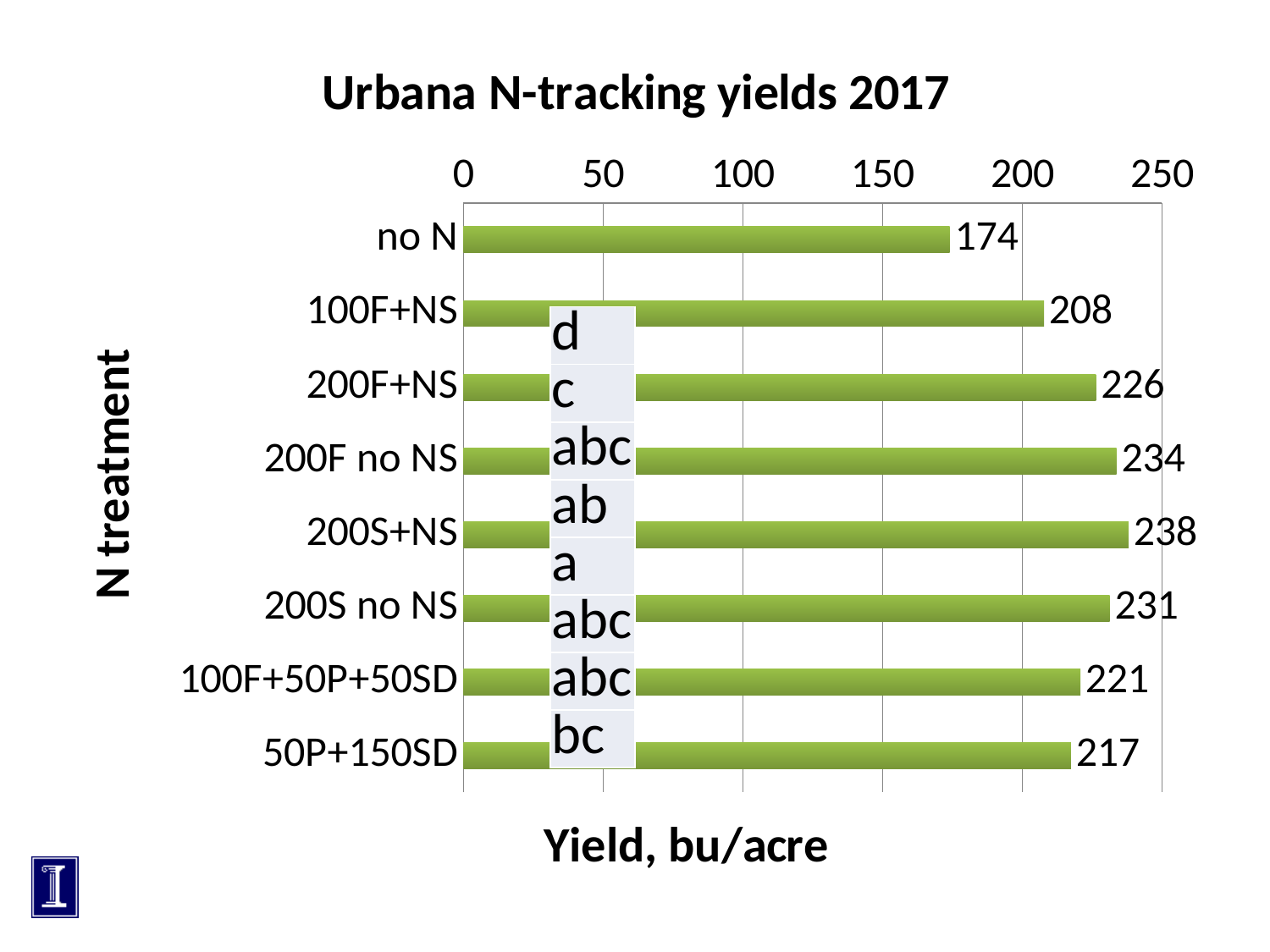
What is the yield for the '200S+NS' treatment? 238 What is the difference in yield between '200F no NS' and '100F+NS'? 26 Is the yield for '200S no NS' greater or less than 200? greater Which N treatment has the lowest yield? no N How many N treatments are shown in the chart? 8 Which has a higher yield, '200F+NS' or '50P+150SD'? 200F+NS What is the yield for the 'no N' treatment? 174 What kind of chart is shown on the slide? bar chart Which N treatment has the highest yield? 200S+NS What is the label of the horizontal axis? Yield, bu/acre What is the title of the chart? Urbana N-tracking yields 2017 What is the yield for the '100F+50P+50SD' treatment? 221